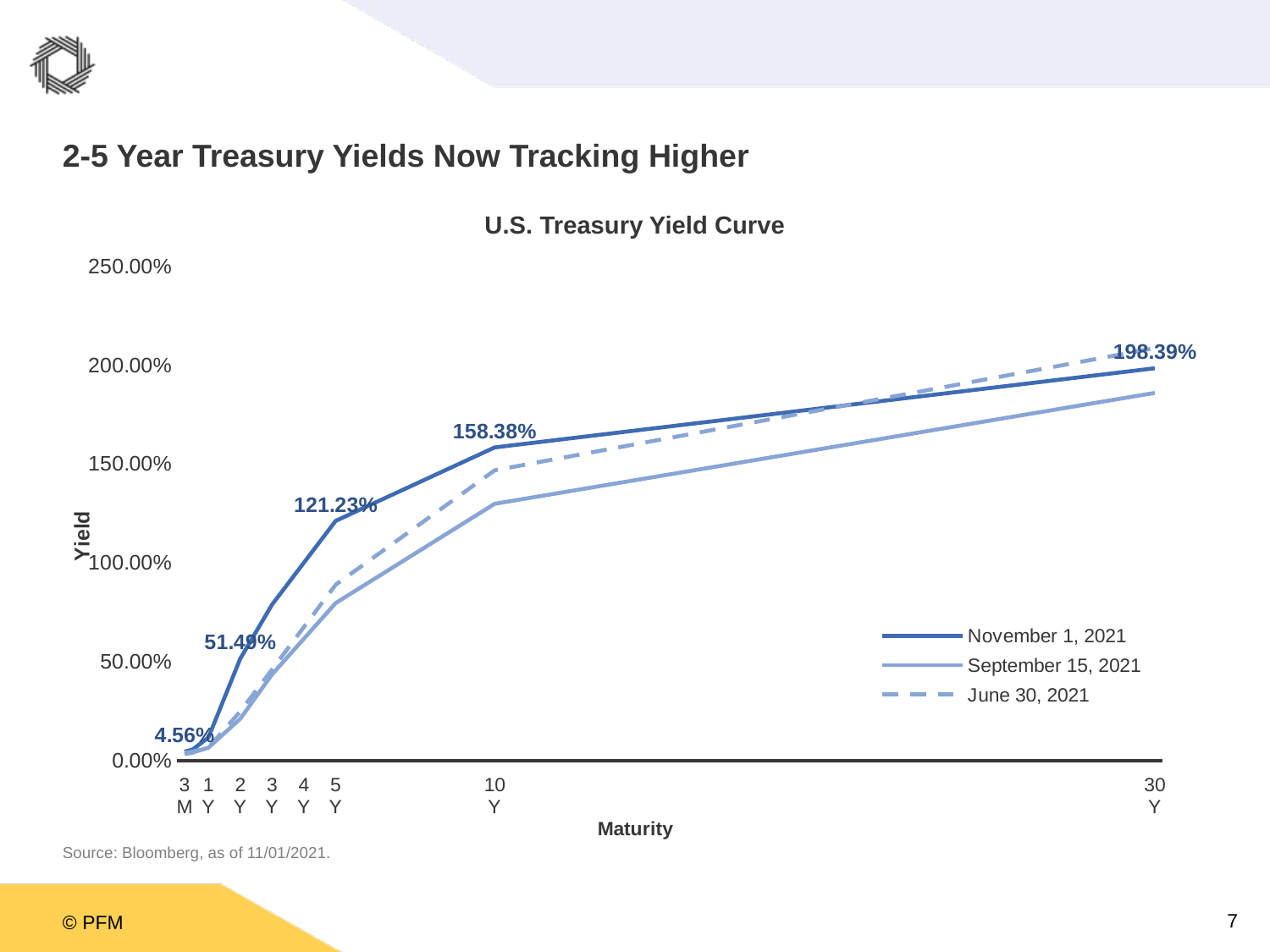
How many maturities are shown on the x axis? 8 What is the November 1, 2021 yield at the 5 Y maturity? 121.23% What is the November 1, 2021 yield at the 30 Y maturity? 198.39% What is the November 1, 2021 yield at the 10 Y maturity? 158.38% Is the September 15, 2021 yield at the 30 Y maturity greater or less than 200.00%? less What kind of chart is shown on the slide? Line chart How many series does the legend list? 3 What is the November 1, 2021 yield at the 3 M maturity? 4.56% For the November 1, 2021 series, how much higher is the 30 Y yield than the 10 Y yield? 40.01% Do the November 1, 2021 yields rise or fall as maturity increases along the x axis? Rise At the 5 Y maturity, which series has the higher yield: November 1, 2021 or September 15, 2021? November 1, 2021 For the November 1, 2021 series, what is the difference between the 10 Y and 5 Y yields? 37.15%